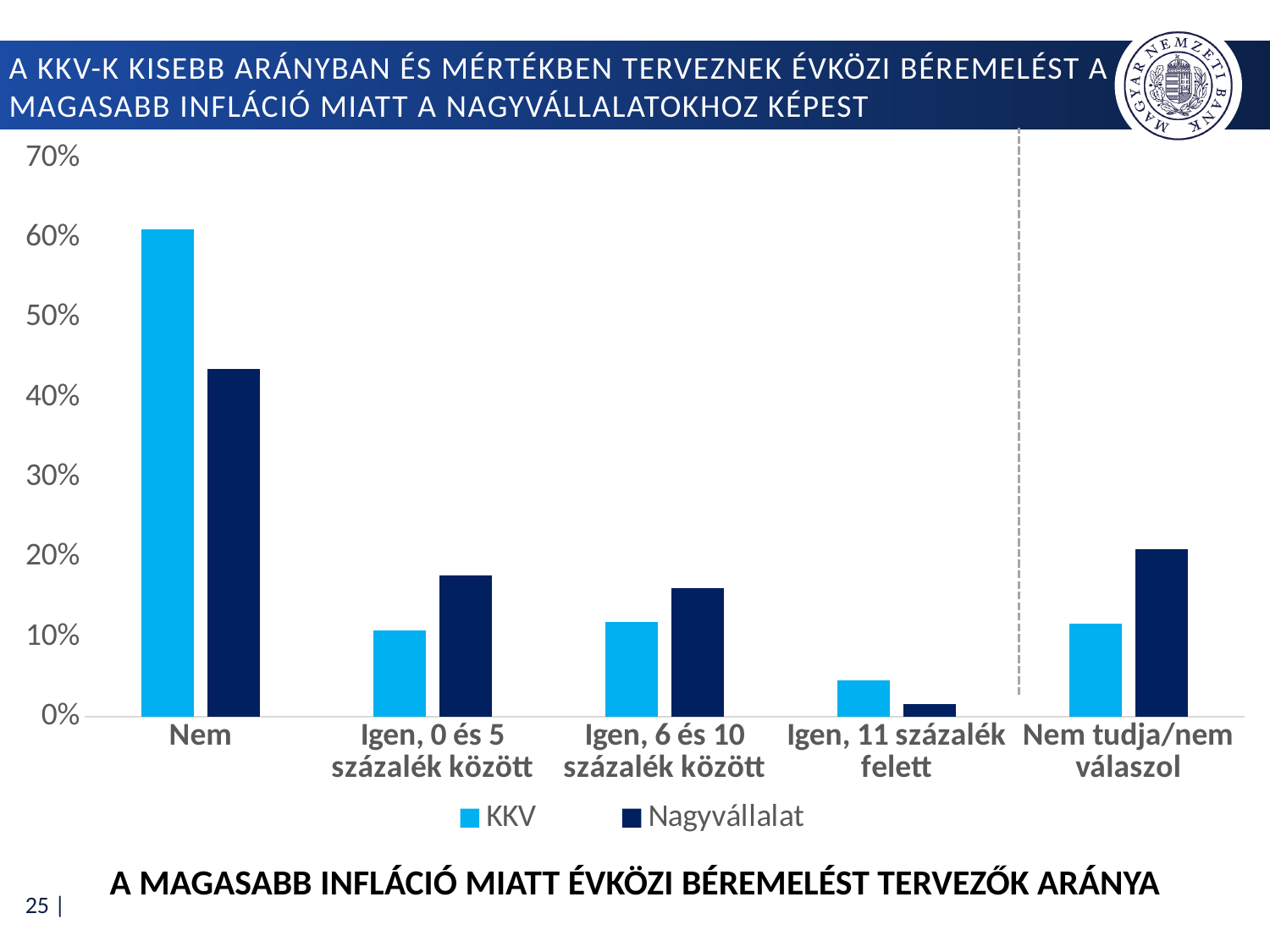
For the category 'Nem', which series has the larger value, KKV or Nagyvállalat? KKV For the category 'Nem tudja/nem válaszol', which series has the larger value, KKV or Nagyvállalat? Nagyvállalat What are the two series named in the legend? KKV and Nagyvállalat Is the Nagyvállalat value for 'Igen, 11 százalék felett' greater or less than 10%? less Which category has the highest value for the KKV series? Nem Is the KKV value for 'Nem' greater or less than 50%? greater Which category has the highest value for the Nagyvállalat series? Nem How many categories are shown on the x axis of the chart? 5 What kind of chart is shown on the slide? bar chart Which category has the lowest value for the Nagyvállalat series? Igen, 11 százalék felett How many series does the legend list? 2